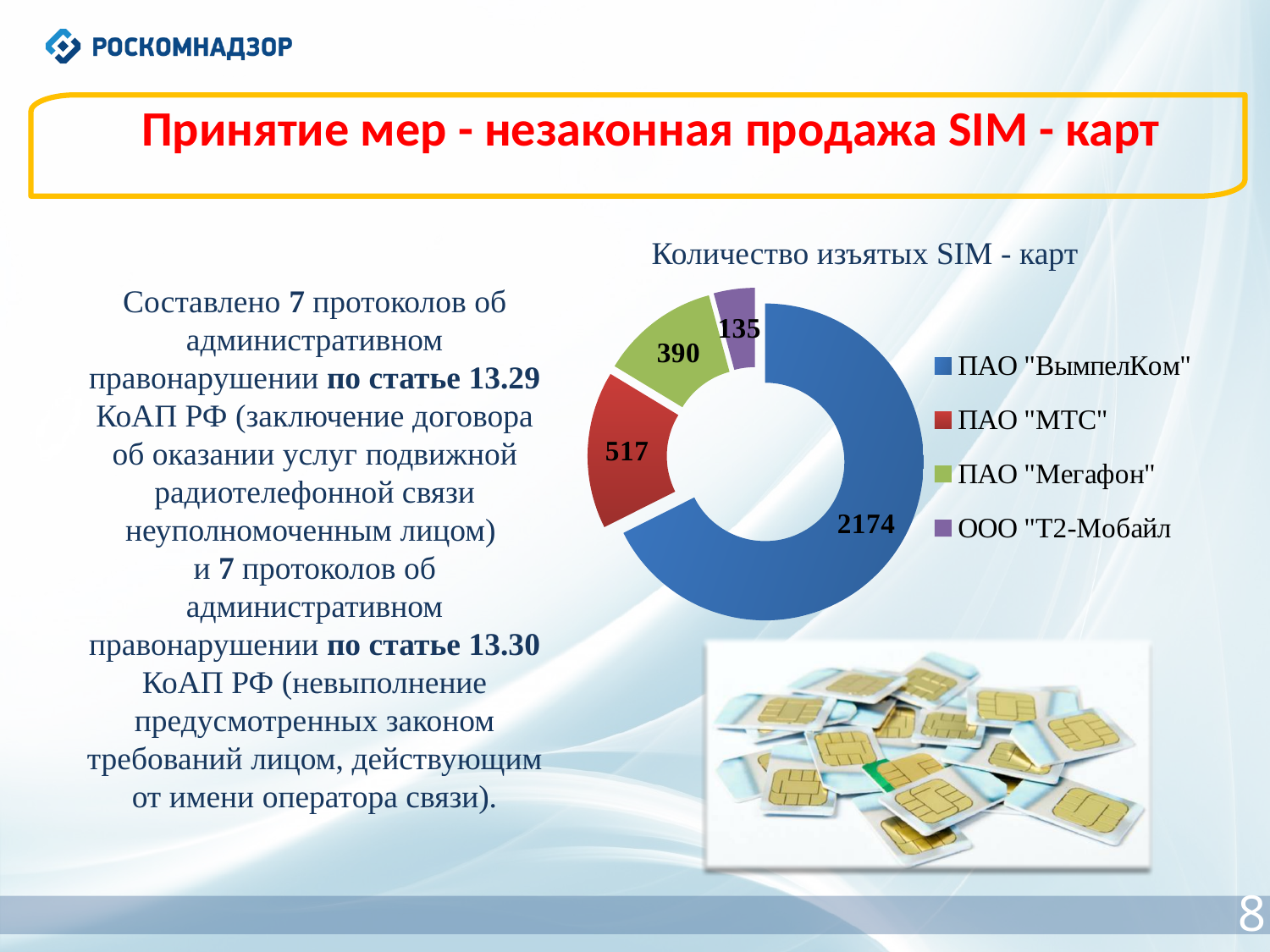
How many entries does the chart legend list? 4 How many categories does the chart show? 4 What kind of chart is shown on the slide? Doughnut (pie) chart Which operator has the highest number of seized SIM cards? ПАО "ВымпелКом" What is the value for ПАО "МТС"? 517 Which is larger, the value for ПАО "Мегафон" or ООО "Т2-Мобайл"? ПАО "Мегафон" Which operator has the lowest number of seized SIM cards? ООО "Т2-Мобайл" What is the value for ООО "Т2-Мобайл"? 135 What is the difference between the values for ПАО "МТС" and ПАО "Мегафон"? 127 What is the value for ПАО "ВымпелКом"? 2174 What is the total number of seized SIM cards across all four operators? 3216 What is the title of the chart on the slide? Количество изъятых SIM - карт